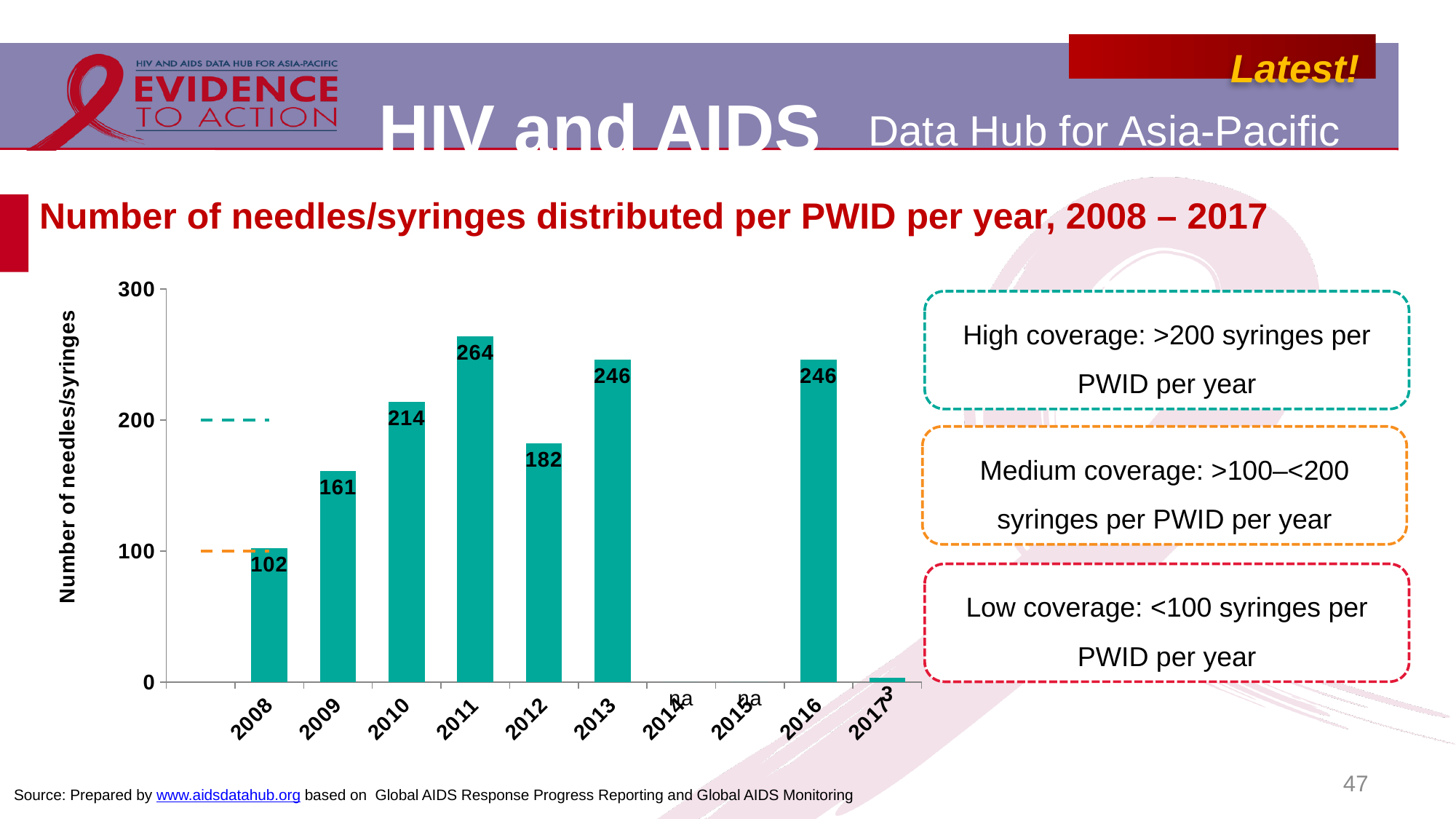
What is shown for 2014 in the chart? na What is the value shown for 2012? 182 What is the number of needles/syringes distributed per PWID in 2011? 264 What is the difference between the values for 2011 and 2010? 50 What kind of chart is used on this slide? bar chart How many years are shown on the x axis of the chart? 10 Which year has the highest number of needles/syringes distributed per PWID? 2011 Which year with a plotted bar has the lowest value? 2017 Which year has the larger value, 2009 or 2012? 2012 What is the difference between the values for 2013 and 2012? 64 Is the value for 2017 greater or less than 100? less What is the value shown for 2008? 102